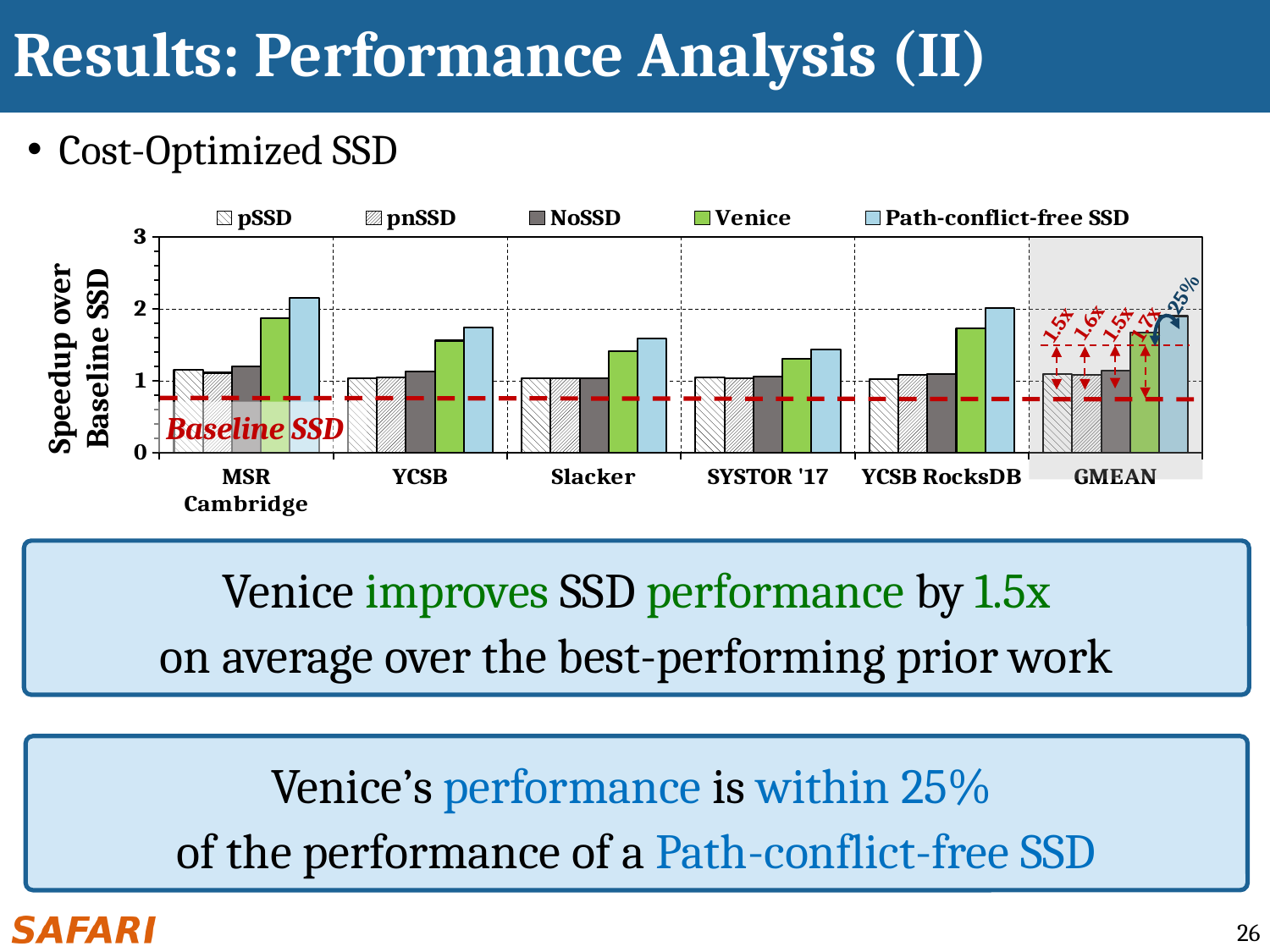
Is the Venice value for Slacker greater or less than 1? greater How many workload categories are shown along the x axis of the chart? 6 What is the title of the chart's y axis? Speedup over Baseline SSD What label is written next to the red dashed horizontal line on the chart? Baseline SSD For YCSB, which is larger: the Venice bar or the NoSSD bar? Venice Is the Venice value for MSR Cambridge greater or less than 2? less Is the Path-conflict-free SSD value for Slacker greater or less than 2? less Which series has the highest bar for GMEAN? Path-conflict-free SSD Which series has the highest bar for MSR Cambridge? Path-conflict-free SSD What kind of chart is shown on the slide? bar chart How many series does the chart's legend list? 5